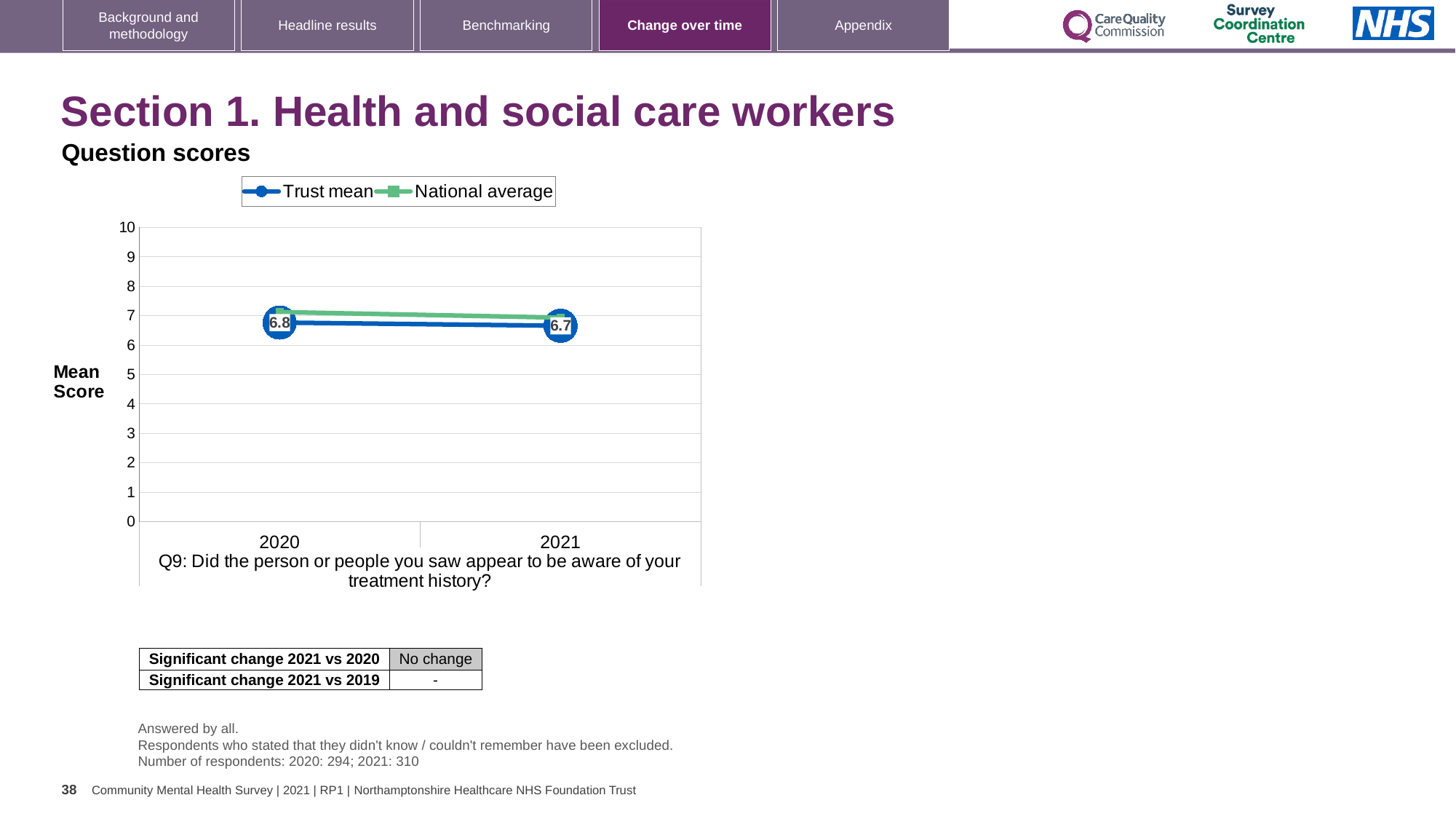
Does the Trust mean rise or fall from 2020 to 2021? fall What is the difference between the Trust mean scores for 2020 and 2021? 0.1 What is the Trust mean score for 2020? 6.8 Which year has the higher Trust mean score, 2020 or 2021? 2020 How many series does the legend list? 2 What is the Trust mean score for 2021? 6.7 Is the National average value for 2020 greater or less than 5? greater What kind of chart is shown on the slide? line chart What are the two series named in the legend? Trust mean and National average Is the National average value for 2021 greater or less than 8? less How many years are plotted on the x axis? 2 What is the label on the y axis of the chart? Mean Score